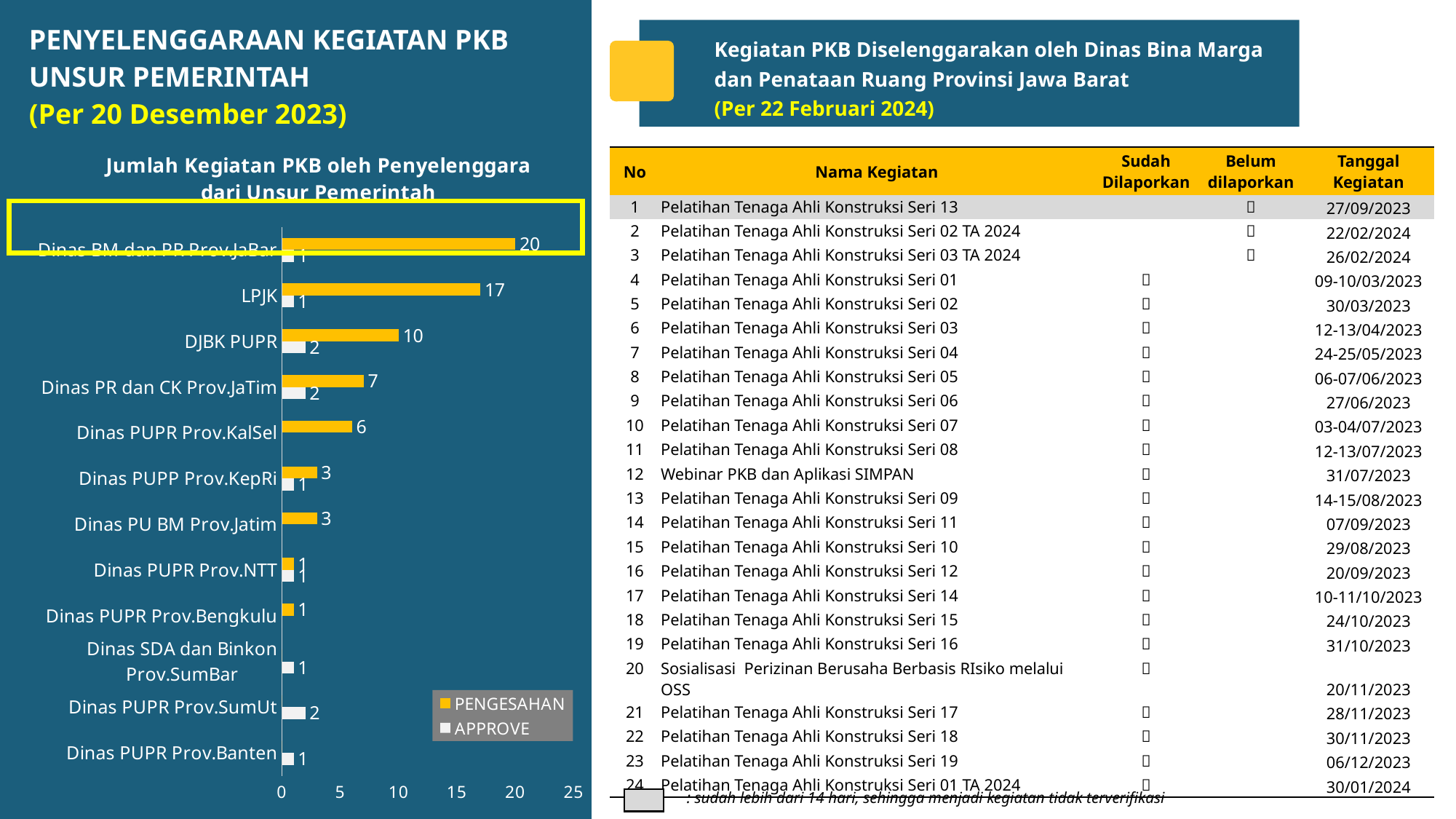
What is the APPROVE value for Dinas PUPR Prov.SumUt? 2 What is the PENGESAHAN value for Dinas PUPR Prov.KalSel? 6 What is the APPROVE value for DJBK PUPR? 2 What is the title of the chart? Jumlah Kegiatan PKB oleh Penyelenggara dari Unsur Pemerintah What is the PENGESAHAN value for LPJK? 17 Which is larger, the PENGESAHAN value for DJBK PUPR or for Dinas PR dan CK Prov.JaTim? DJBK PUPR How many categories are shown on the chart's vertical axis? 12 Which category has the highest PENGESAHAN value? Dinas BM dan PR Prov.JaBar What is the difference between the PENGESAHAN values for Dinas BM dan PR Prov.JaBar and LPJK? 3 What type of chart is shown on the slide? bar chart How many series does the chart legend list? 2 What is the PENGESAHAN value for Dinas BM dan PR Prov.JaBar? 20